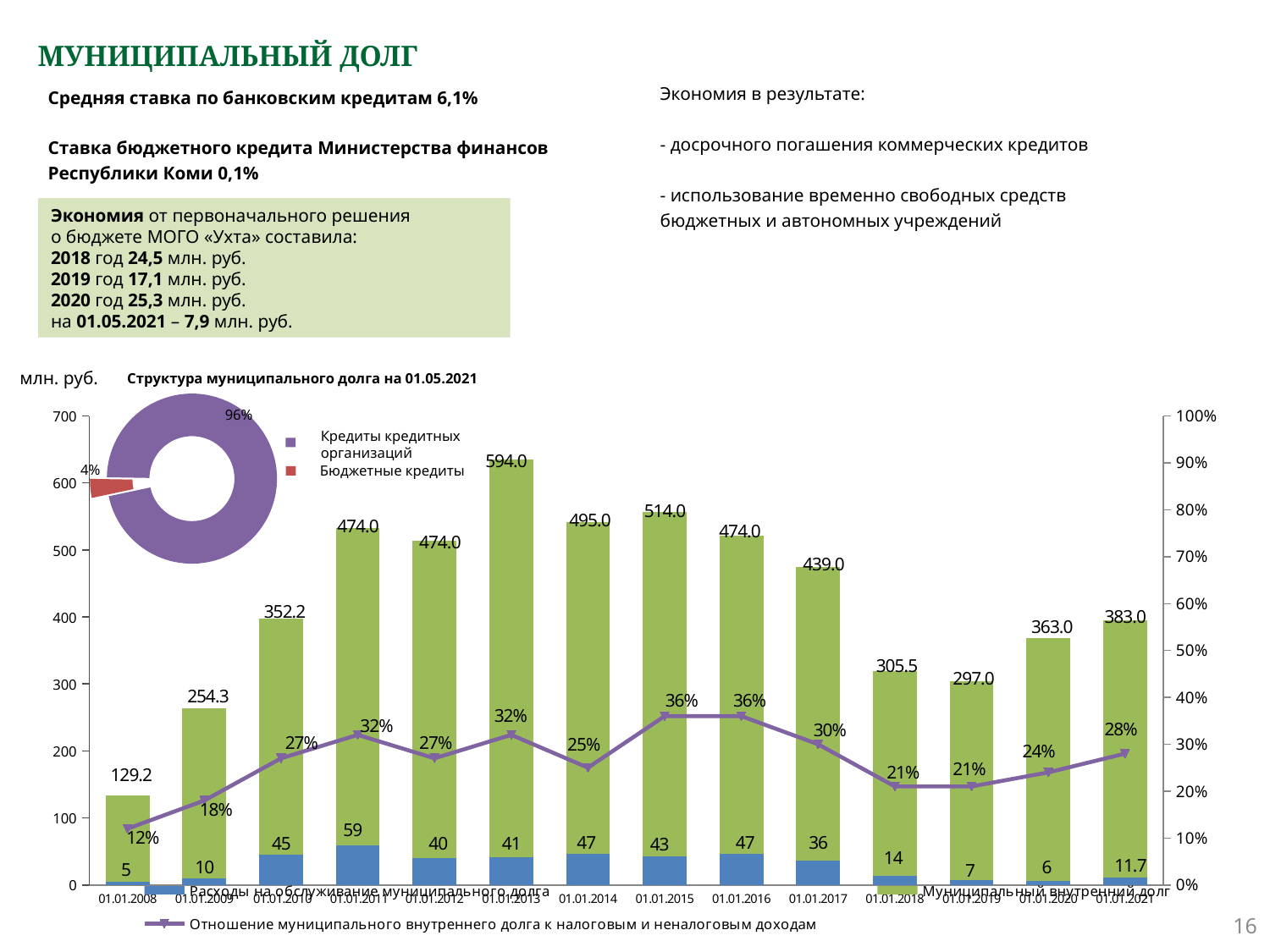
In the bar chart at the bottom, what is the difference between 'Муниципальный внутренний долг' on 01.01.2021 and on 01.01.2020? 20.0 How many series does the legend of the bar chart at the bottom list? 3 How many dates are shown on the x axis of the bar chart at the bottom? 14 In the bar chart at the bottom, what is the value of 'Отношение муниципального внутреннего долга к налоговым и неналоговым доходам' for 01.01.2021? 28% In the donut chart 'Структура муниципального долга на 01.05.2021', what share is 'Бюджетные кредиты'? 4% What type of chart is 'Структура муниципального долга на 01.05.2021'? Donut (pie) chart In the bar chart at the bottom, which date has the lowest value of 'Муниципальный внутренний долг'? 01.01.2008 In the bar chart at the bottom, what is the value of 'Муниципальный внутренний долг' for 01.01.2013? 594.0 In the bar chart at the bottom, which is larger: 'Муниципальный внутренний долг' on 01.01.2015 or on 01.01.2017? 01.01.2015 In the donut chart 'Структура муниципального долга на 01.05.2021', what share is 'Кредиты кредитных организаций'? 96% In the bar chart at the bottom, which date has the highest value of 'Муниципальный внутренний долг'? 01.01.2013 In the bar chart at the bottom, what is the value of 'Расходы на обслуживание муниципального долга' for 01.01.2011? 59